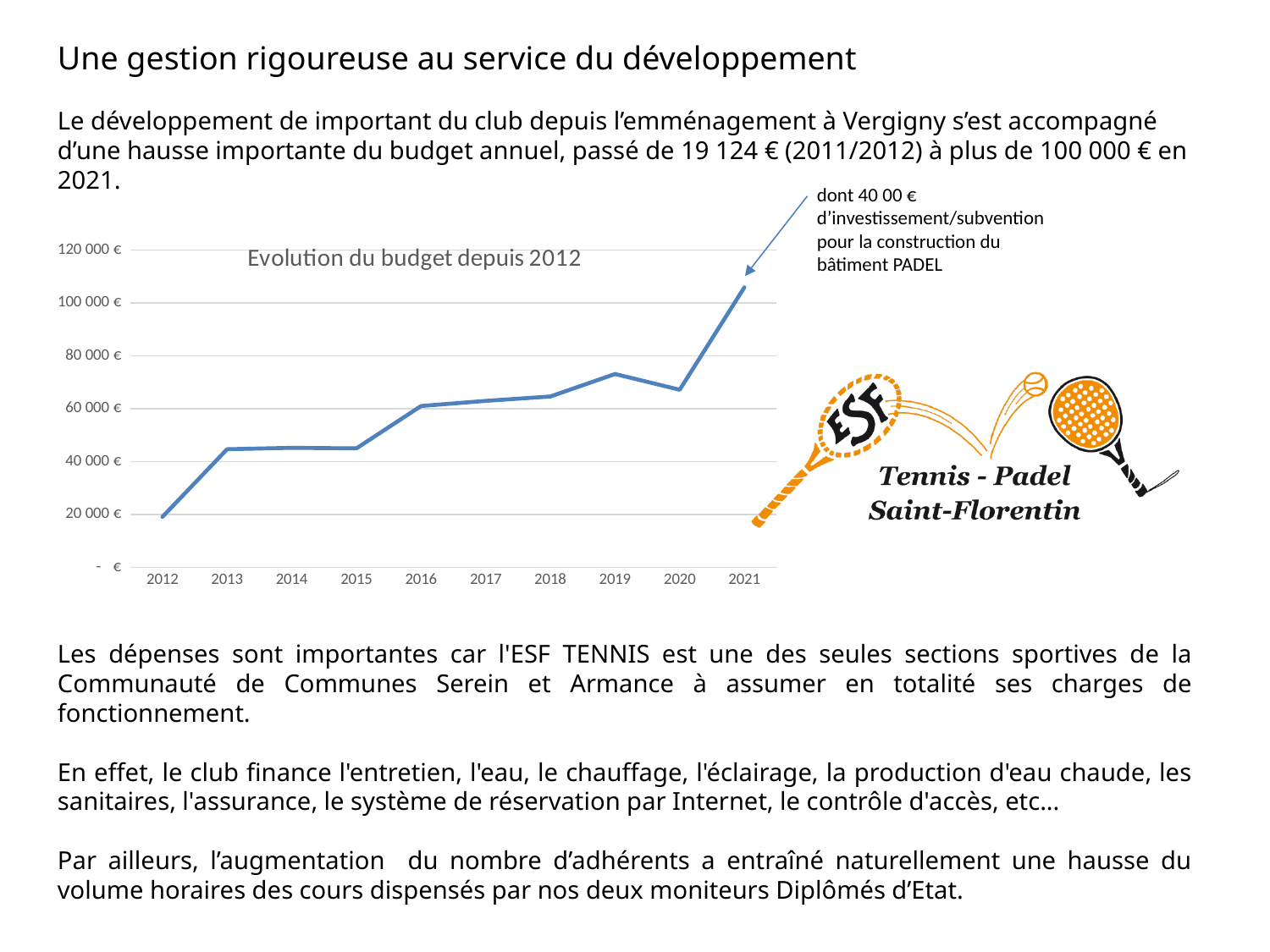
Is the value for 2021 greater or less than 100 000 €? greater Is the value for 2018 greater or less than 80 000 €? less How many years are plotted on the x axis of the chart? 10 Which year has the larger budget, 2019 or 2020? 2019 Overall, does the budget rise or fall from 2012 to 2021? rise Which year has the highest budget in the chart? 2021 Which year has the larger budget, 2016 or 2012? 2016 What is the title of the chart? Evolution du budget depuis 2012 Is the value for 2019 greater or less than 60 000 €? greater What kind of chart is shown on the slide? line chart Which year has the lowest budget in the chart? 2012